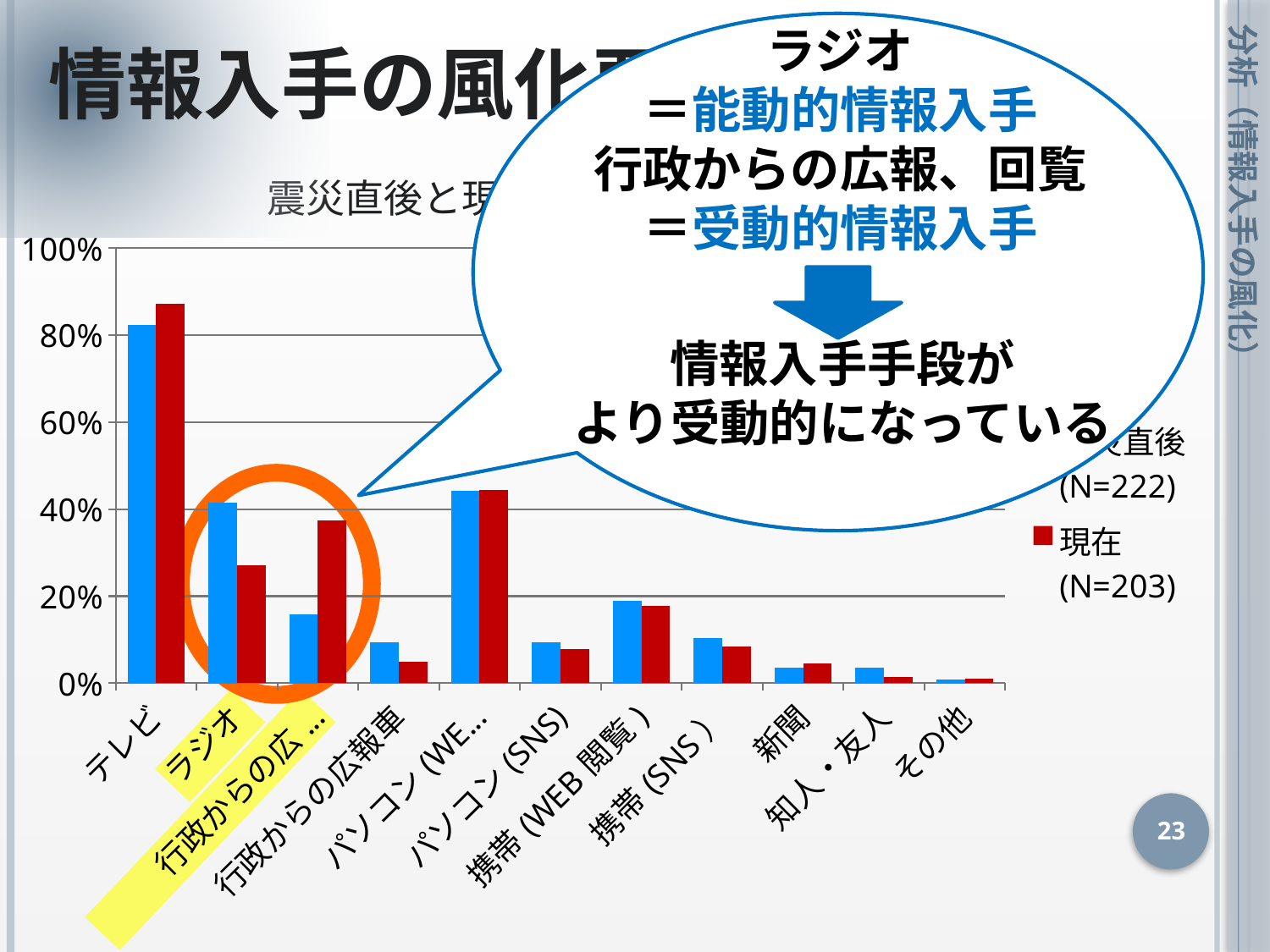
How many series does the chart's legend list? 2 For 行政からの広報車, which series has the larger value, the blue series or the 現在 (N=203) series? the blue series Which category has the highest value for the 現在 (N=203) series? テレビ How many categories are shown along the x axis of the chart? 11 Which category has the highest value for the blue series? テレビ What colour are the bars for the 現在 (N=203) series? red Is the value for 行政からの広報車 in the 現在 (N=203) series greater or less than 20%? less Is the value for テレビ in the 現在 (N=203) series greater or less than 80%? greater Which category has the lowest value for the 現在 (N=203) series? その他 For ラジオ, which series has the larger value, the blue series or the 現在 (N=203) series? the blue series What kind of chart is shown on the slide? bar chart Is the value for ラジオ in the 現在 (N=203) series greater or less than 40%? less